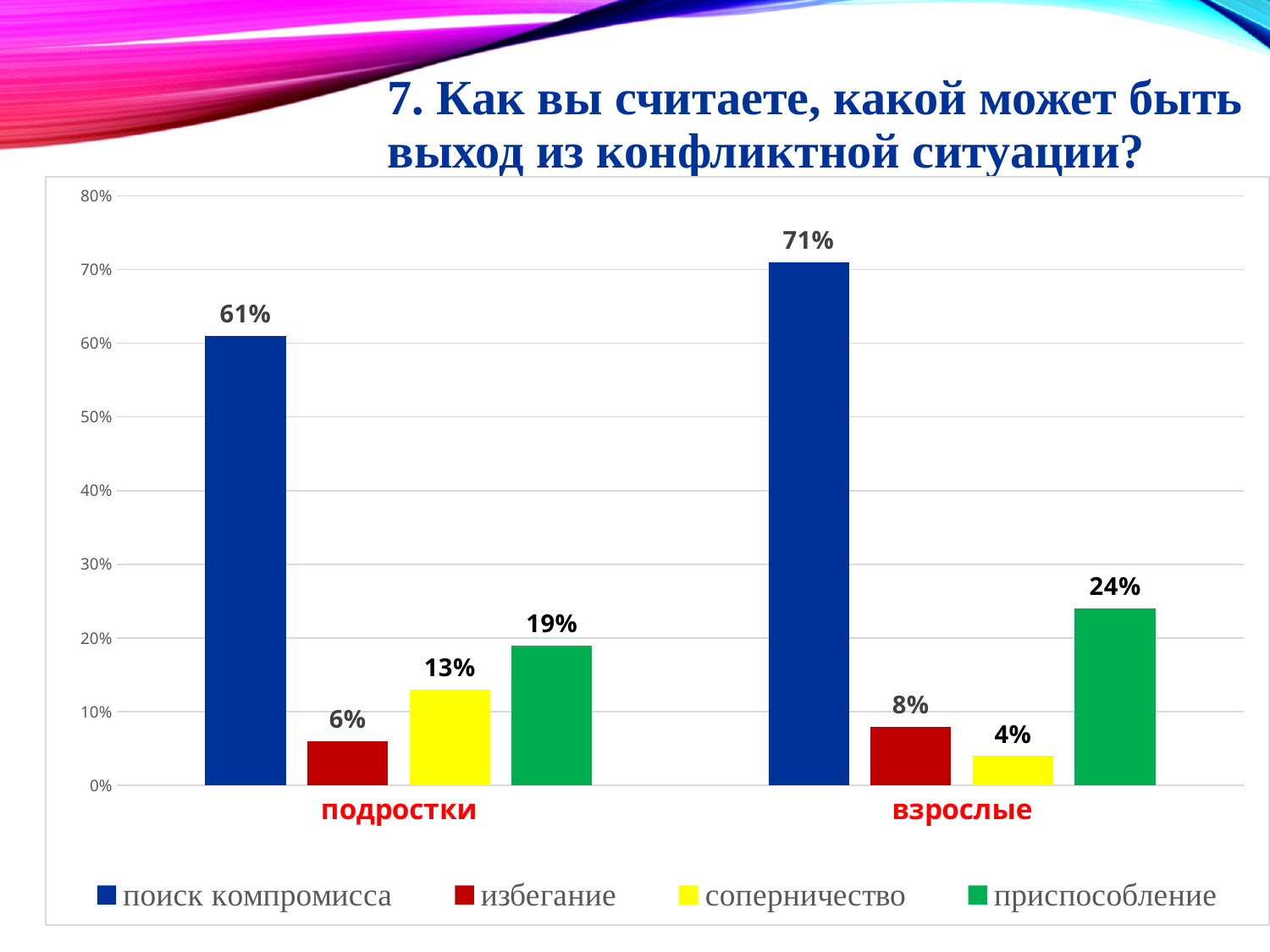
Which series has the lowest value for подростки? избегание How many series does the legend list? 4 What colour are the bars for соперничество? yellow What is the value for поиск компромисса among подростки? 61% What is the difference between поиск компромисса for взрослые and for подростки? 10% Which is larger: избегание for подростки or избегание for взрослые? взрослые What is the value for соперничество among взрослые? 4% What is the value for приспособление among взрослые? 24% How many categories are shown on the x axis? 2 Is the value for приспособление among подростки greater or less than 20%? less Which series has the highest value for взрослые? поиск компромисса What kind of chart is shown on the slide? bar chart